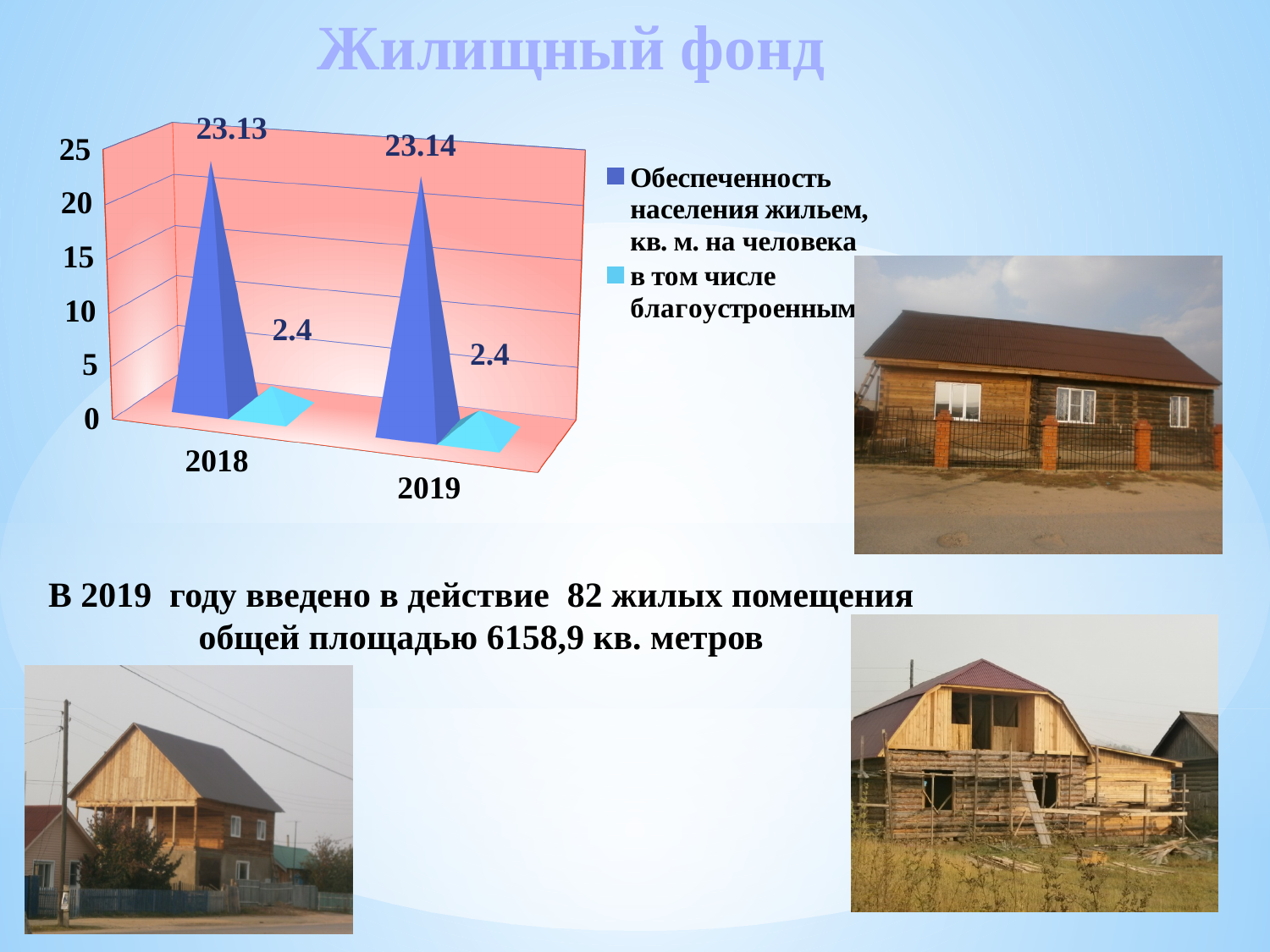
What is the difference between 'Обеспеченность населения жильем' and 'в том числе благоустроенным' in 2018? 20.73 What is the difference between 'Обеспеченность населения жильем' and 'в том числе благоустроенным' in 2019? 20.74 Is the value for 'Обеспеченность населения жильем' in 2018 greater or less than 20? greater What is the value of 'Обеспеченность населения жильем, кв. м. на человека' for 2019? 23.14 What is the value of 'в том числе благоустроенным' for 2018? 2.4 Which series has the larger value in 2019, 'Обеспеченность населения жильем' or 'в том числе благоустроенным'? Обеспеченность населения жильем What is the title of the slide containing the chart? Жилищный фонд What is the value of 'в том числе благоустроенным' for 2019? 2.4 How many series does the chart legend list? 2 Is the value for 'в том числе благоустроенным' in 2019 greater or less than 5? less How many years are shown on the x axis of the chart? 2 What is the value of 'Обеспеченность населения жильем, кв. м. на человека' for 2018? 23.13